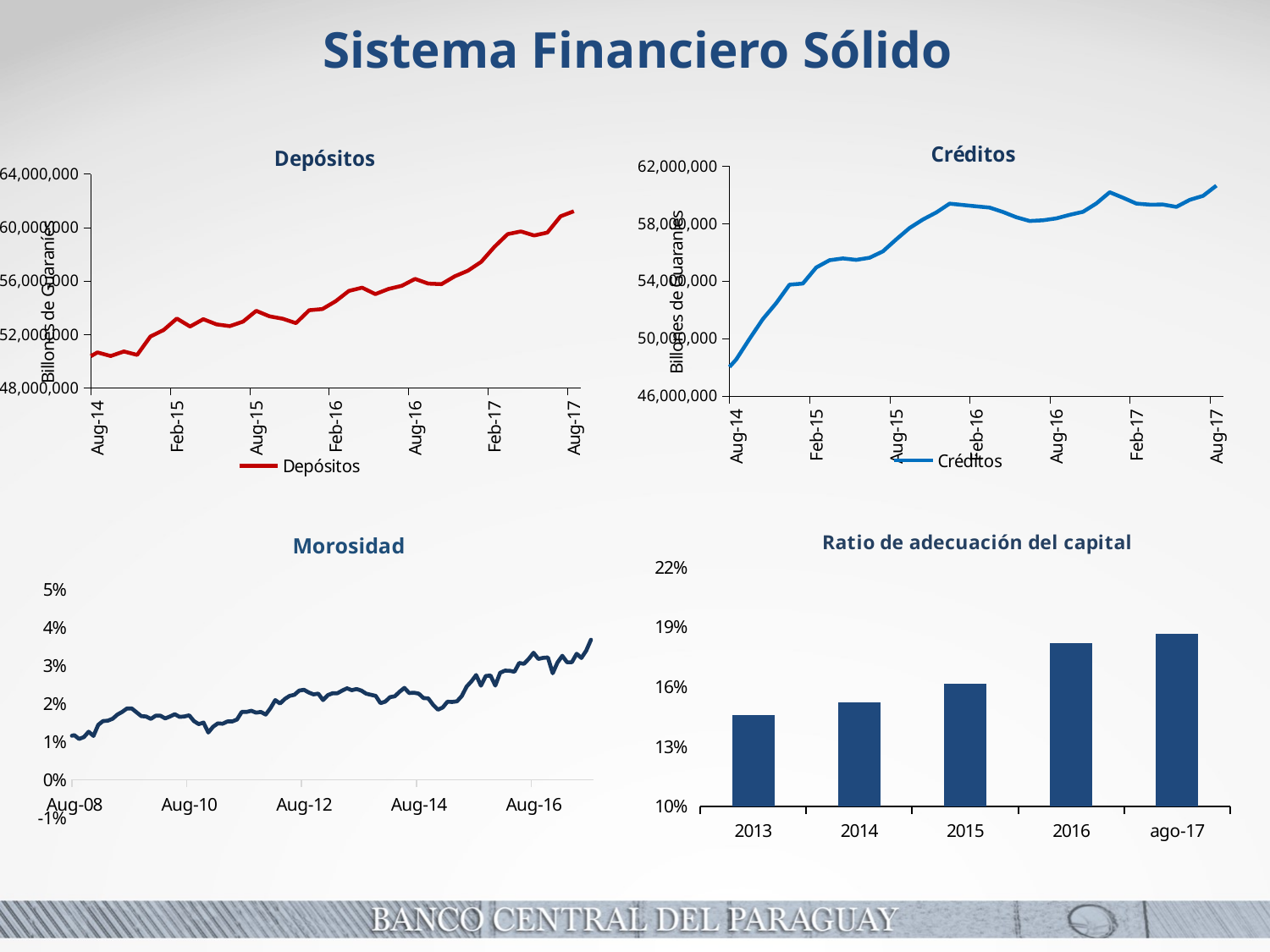
In the 'Ratio de adecuación del capital' chart, is the value for 2013 greater or less than 16%? less What kind of chart is the 'Depósitos' chart? line chart In the 'Ratio de adecuación del capital' chart, which category has the lowest value? 2013 In the 'Depósitos' chart, do the values generally rise or fall from Aug-14 to Aug-17? rise In the 'Morosidad' chart, do the values generally rise or fall from Aug-08 to the end of the series? rise In the 'Ratio de adecuación del capital' chart, which category has the highest value? ago-17 In the 'Ratio de adecuación del capital' chart, how many categories are shown on the x axis? 5 What kind of chart is the 'Ratio de adecuación del capital' chart? bar chart In the 'Depósitos' chart, is the value at Aug-14 greater or less than 52,000,000? less In the 'Ratio de adecuación del capital' chart, which is larger, the value for 2015 or the value for 2016? 2016 What is the y-axis label on the 'Créditos' chart? Billones de Guaraníes In the 'Créditos' chart, is the value at Aug-14 greater or less than 50,000,000? less